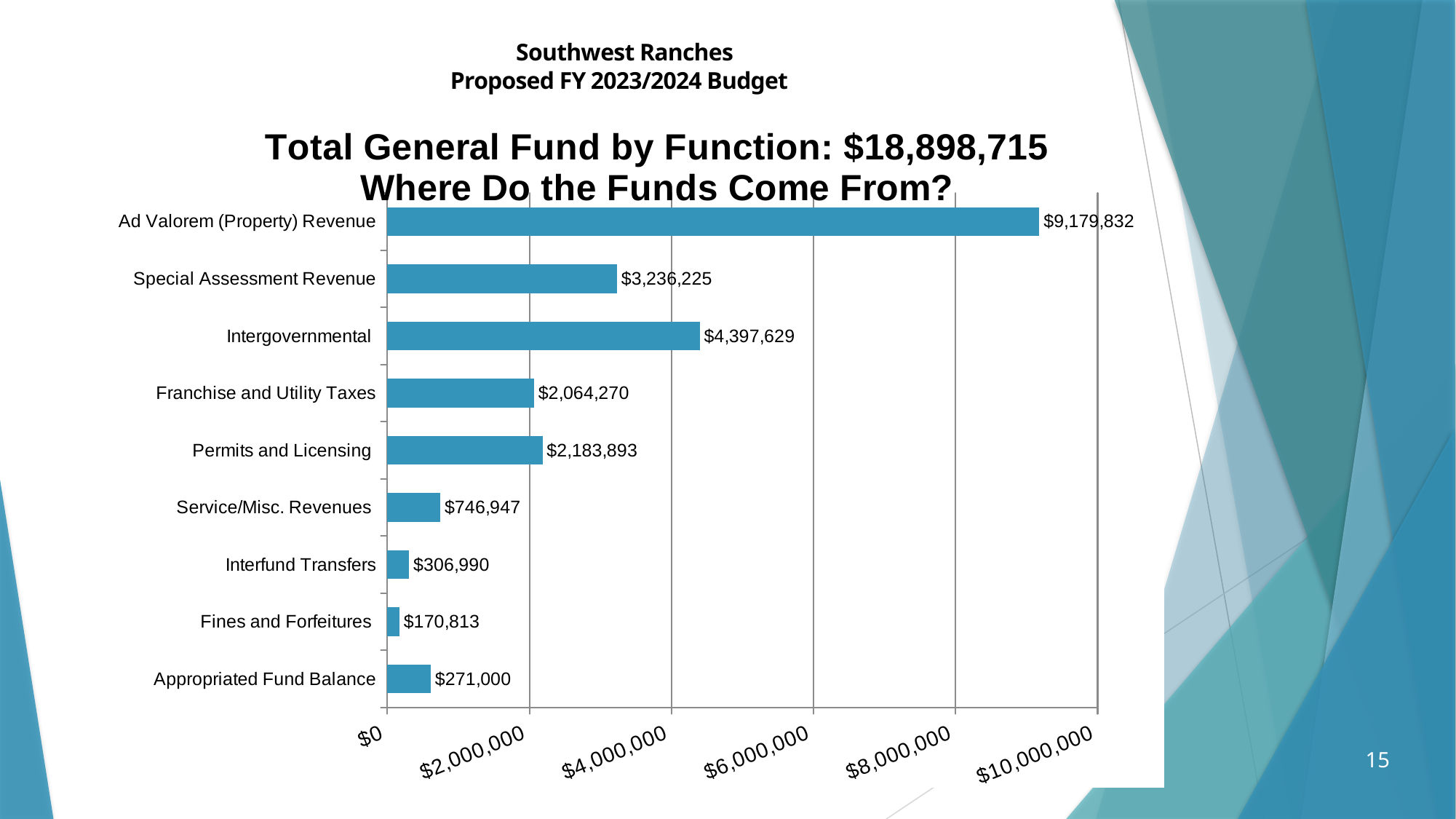
What is the difference between Permits and Licensing and Franchise and Utility Taxes? $119,623 Which is larger, Intergovernmental or Special Assessment Revenue? Intergovernmental What is the value for Intergovernmental? $4,397,629 Which category has the highest value? Ad Valorem (Property) Revenue What total General Fund amount is stated in the chart title? $18,898,715 What is the value for Ad Valorem (Property) Revenue? $9,179,832 What kind of chart is shown on the slide? bar chart What is the difference between Intergovernmental and Special Assessment Revenue? $1,161,404 Is the value for Ad Valorem (Property) Revenue greater or less than $8,000,000? greater What is the value for Fines and Forfeitures? $170,813 Which category has the lowest value? Fines and Forfeitures How many categories are shown in the chart? 9